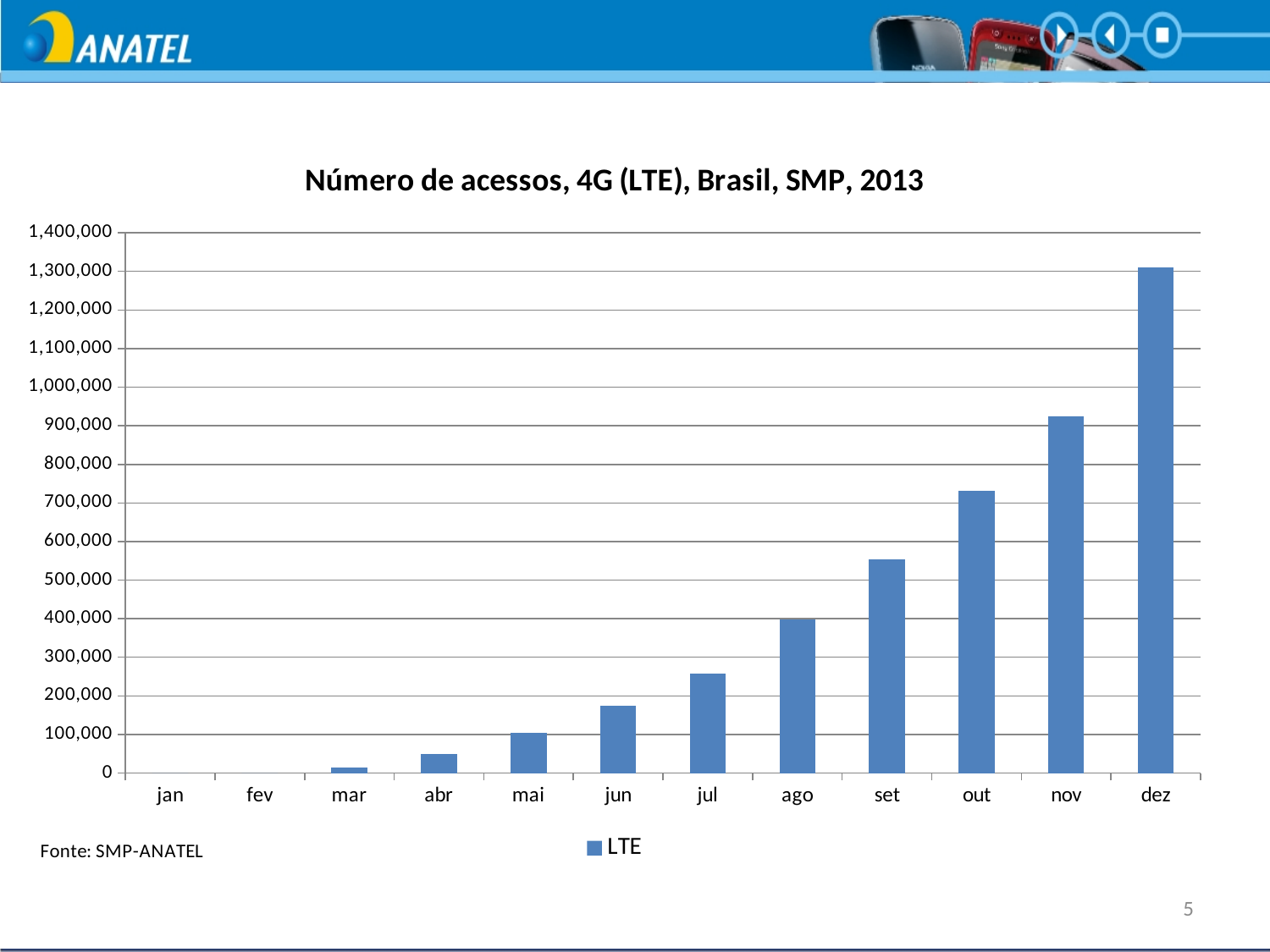
Is the value for abr greater or less than 100,000? less Is the value for set greater or less than 500,000? greater How many series does the legend list? 1 Is the value for dez greater or less than 1,200,000? greater What is the title of the chart? Número de acessos, 4G (LTE), Brasil, SMP, 2013 How many months are shown on the x axis of the chart? 12 Which month has the highest number of LTE accesses? dez Which month has the larger value, out or ago? out What kind of chart is shown on the slide? bar chart Do the values rise or fall from jan to dez? rise